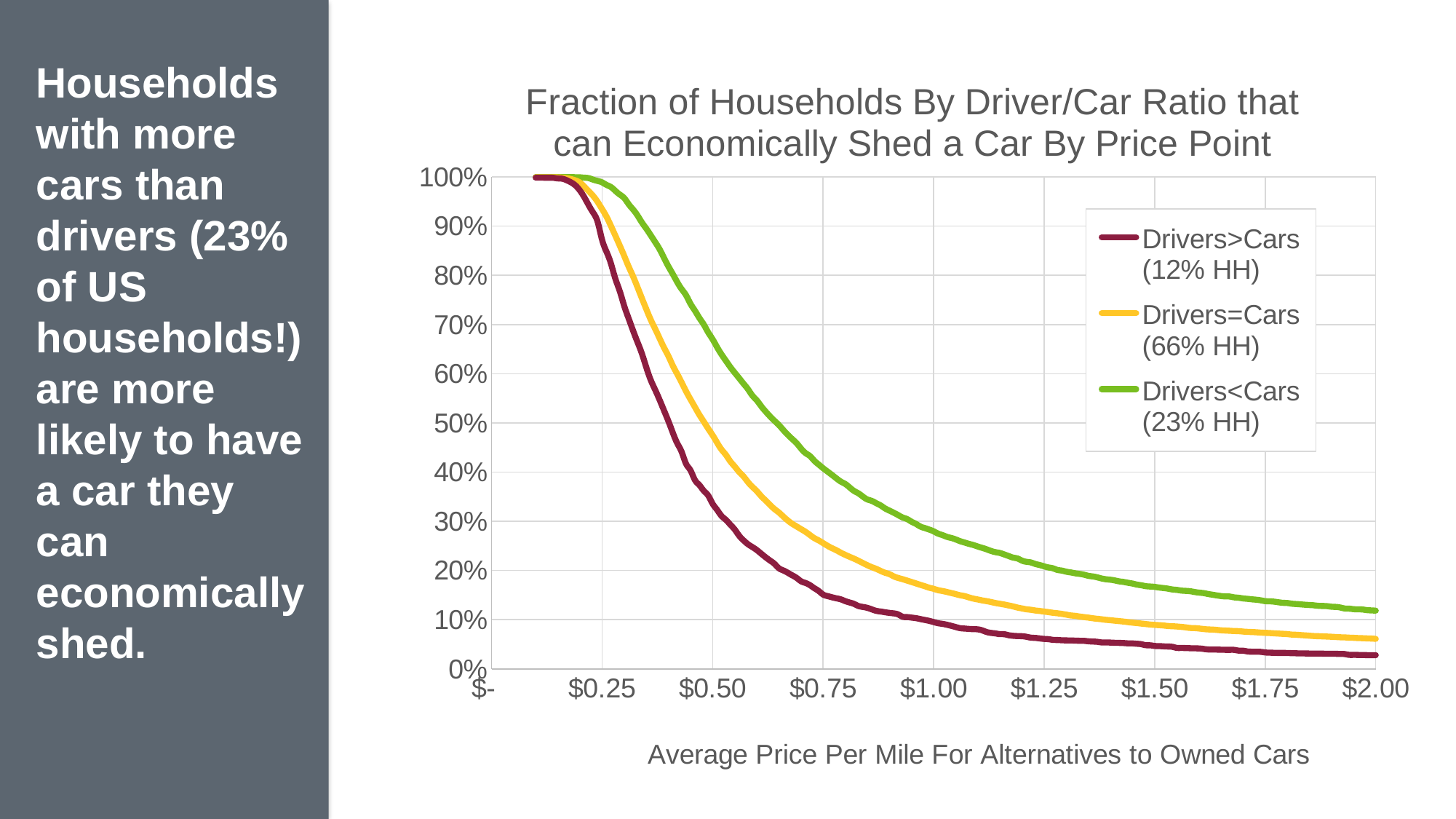
Is the value for Drivers<Cars (23% HH) at $0.50 per mile greater or less than 60%? greater Do the values for each series rise or fall as the average price per mile increases along the x axis? fall At $1.00 per mile, which series has the higher value: Drivers<Cars (23% HH) or Drivers>Cars (12% HH)? Drivers<Cars (23% HH) Is the value for Drivers<Cars (23% HH) at $1.00 per mile greater or less than 20%? greater How many series does the legend list? 3 Is the value for Drivers>Cars (12% HH) at $1.00 per mile greater or less than 20%? less At $0.50 per mile, which series has the lowest value? Drivers>Cars (12% HH) What is the title of the chart? Fraction of Households By Driver/Car Ratio that can Economically Shed a Car By Price Point What is the label of the x axis? Average Price Per Mile For Alternatives to Owned Cars At $2.00 per mile, which series has the highest value? Drivers<Cars (23% HH) What kind of chart is shown on the slide? line chart